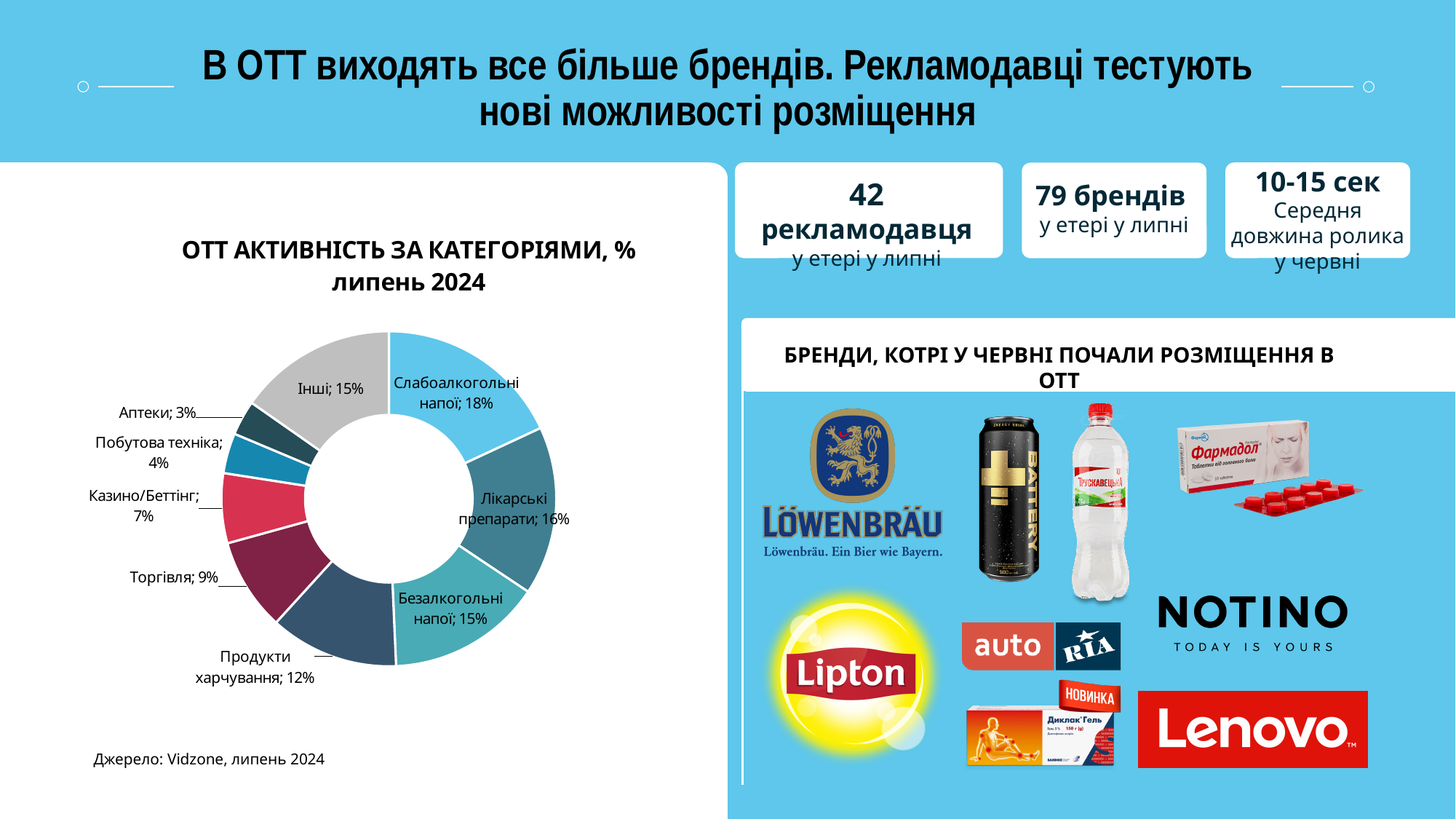
What is the value for Слабоалкогольні напої in the chart? 18% What is the source cited below the chart? Vidzone, липень 2024 What is the value for Продукти харчування in the chart? 12% What is the value for Лікарські препарати in the chart? 16% Which is larger: the share of Торгівля or the share of Побутова техніка? Торгівля Which category has the largest share in the chart? Слабоалкогольні напої Which category has the smallest share in the chart? Аптеки How many categories are shown in the chart? 9 What is the title of the chart? ОТТ АКТИВНІСТЬ ЗА КАТЕГОРІЯМИ, % липень 2024 What type of chart is shown on the slide? Doughnut (pie) chart What is the difference between the shares of Слабоалкогольні напої and Безалкогольні напої? 3% What is the value for Казино/Беттінг in the chart? 7%